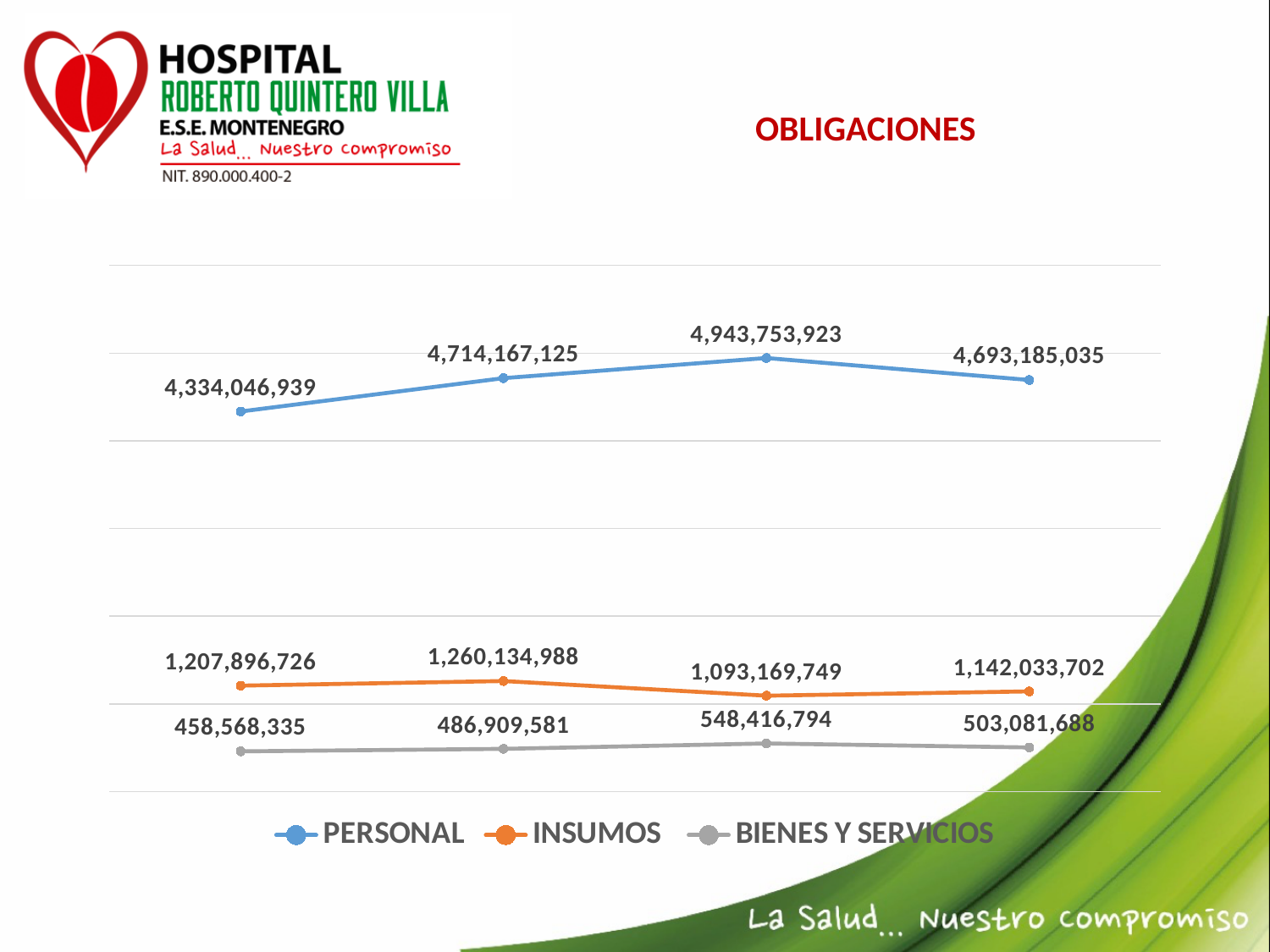
What is the difference between the second and third values of the INSUMOS series? 166,965,239 What is the highest value shown for the BIENES Y SERVICIOS series? 548,416,794 How many series does the legend list? 3 What is the difference between the highest and lowest values of the PERSONAL series? 609,706,984 What is the lowest value shown for the INSUMOS series? 1,093,169,749 Which series has the larger value at the third point, INSUMOS or BIENES Y SERVICIOS? INSUMOS What is the value of the INSUMOS series at the fourth (last) point on the chart? 1,142,033,702 What is the value of the BIENES Y SERVICIOS series at the second point on the chart? 486,909,581 What kind of chart is shown on the slide? Line chart What is the value of the PERSONAL series at the first point on the chart? 4,334,046,939 How many data points does each series have on the chart? 4 What is the highest value shown for the PERSONAL series? 4,943,753,923